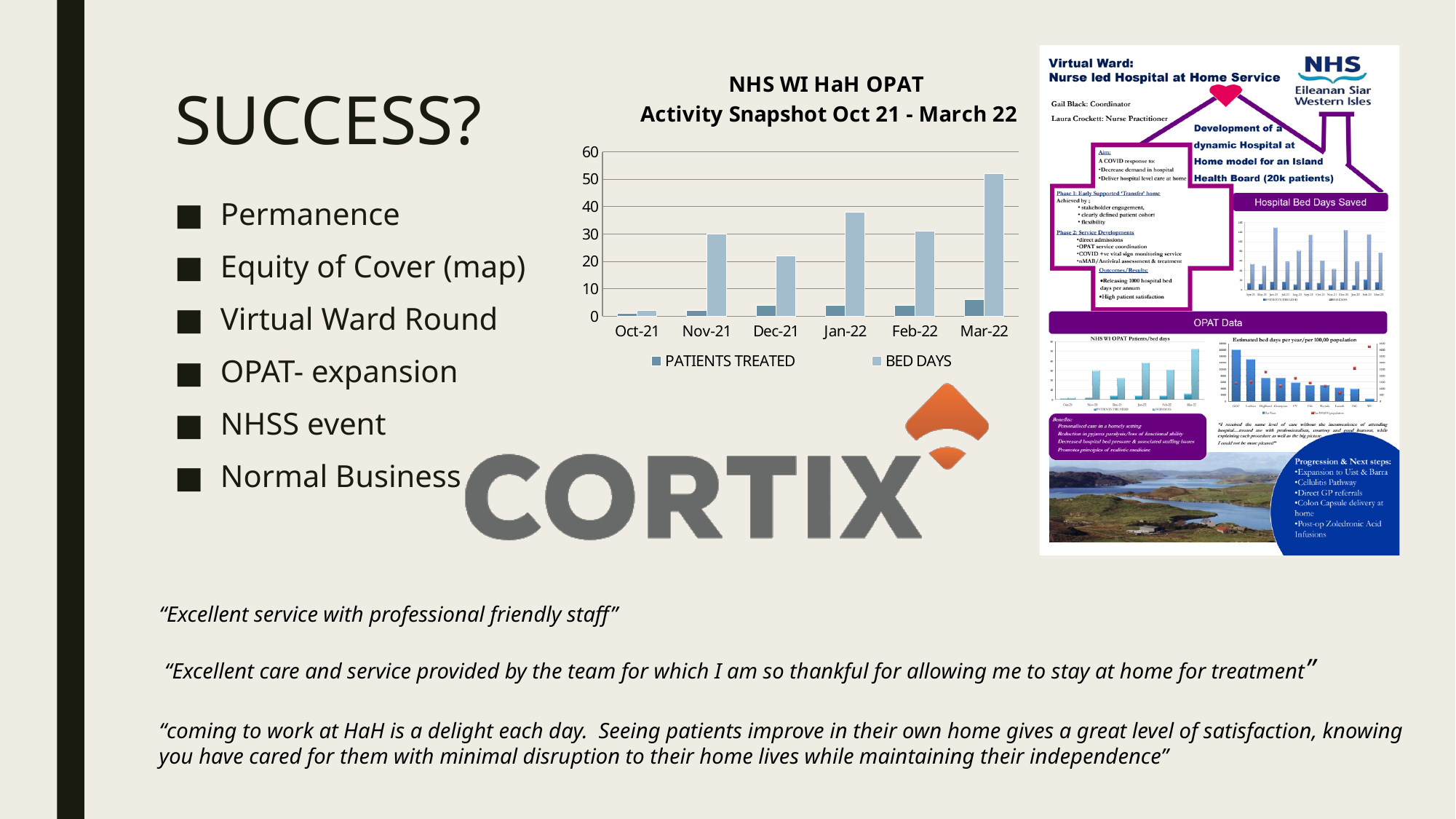
In the NHS WI HaH OPAT Activity Snapshot chart, is the BED DAYS value for Dec-21 greater or less than 30? less How many series does the legend of the NHS WI HaH OPAT Activity Snapshot chart list? 2 In the NHS WI HaH OPAT Activity Snapshot chart, is the BED DAYS value for Jan-22 greater or less than 30? greater In the NHS WI HaH OPAT Activity Snapshot chart, which month has the highest BED DAYS value? Mar-22 In the NHS WI HaH OPAT Activity Snapshot chart, is the BED DAYS value for Mar-22 greater or less than 40? greater What kind of chart is the NHS WI HaH OPAT Activity Snapshot chart? bar chart What is the title of the bar chart in the middle of the slide? NHS WI HaH OPAT Activity Snapshot Oct 21 - March 22 In the NHS WI HaH OPAT Activity Snapshot chart, which month has more BED DAYS, Nov-21 or Dec-21? Nov-21 In the NHS WI HaH OPAT Activity Snapshot chart, which month has the lowest BED DAYS value? Oct-21 How many months are shown on the x axis of the NHS WI HaH OPAT Activity Snapshot chart? 6 In the NHS WI HaH OPAT Activity Snapshot chart, which month has the highest PATIENTS TREATED value? Mar-22 In the NHS WI HaH OPAT Activity Snapshot chart, which month has more BED DAYS, Jan-22 or Feb-22? Jan-22